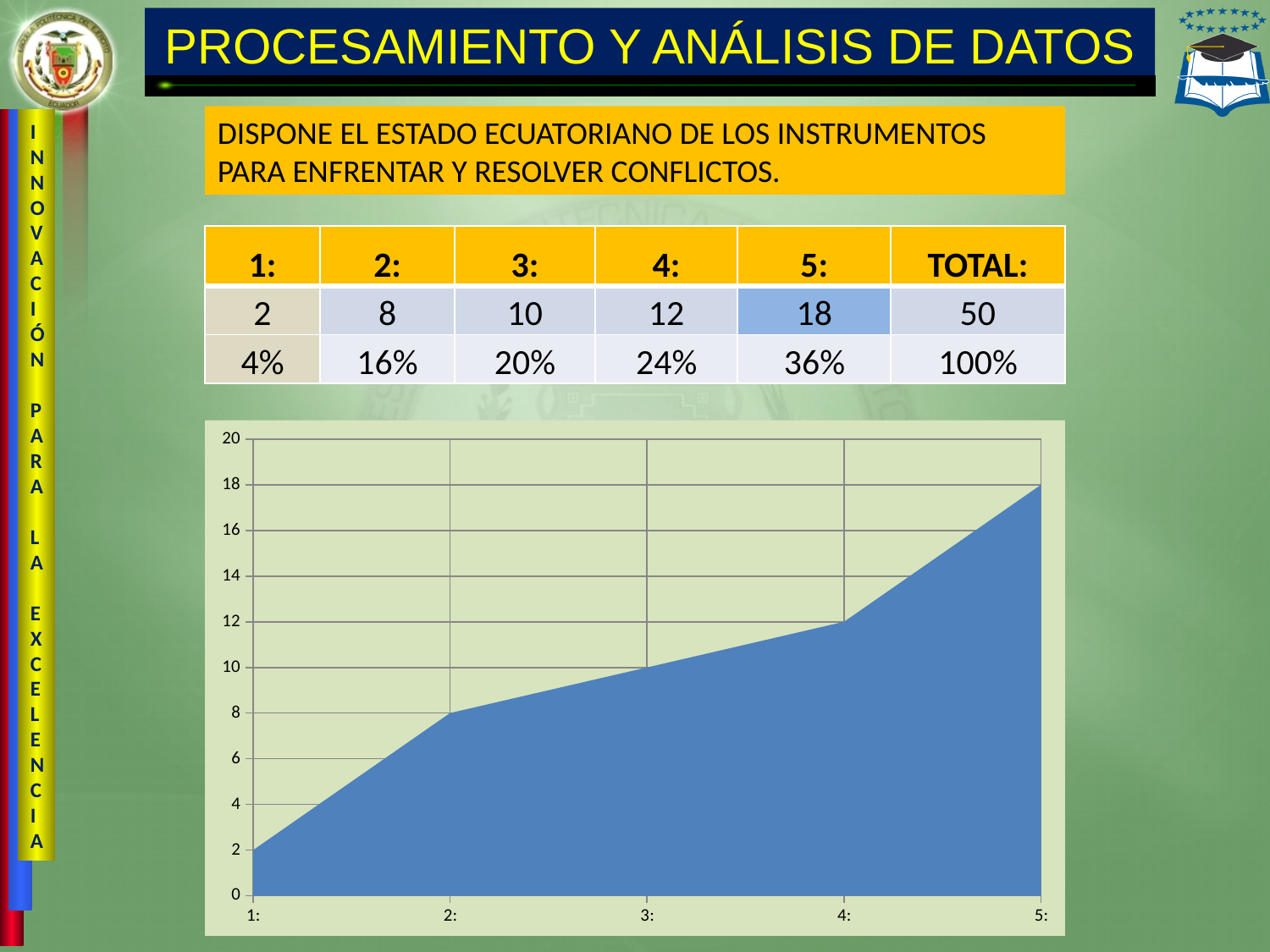
What kind of chart is shown on the slide? area chart What is the value plotted for category 2:? 8 Do the values rise or fall from category 1: to category 5:? rise What is the value plotted for category 1:? 2 Which category has the lowest value in the chart? 1: What is the value plotted for category 5:? 18 What is the maximum value shown on the chart's vertical axis? 20 Which is larger, the value for category 3: or the value for category 2:? 3: Is the value for category 4: greater or less than 10? greater How many categories are plotted along the x axis of the chart? 5 What is the difference between the values for category 5: and category 4:? 6 Which category has the highest value in the chart? 5: